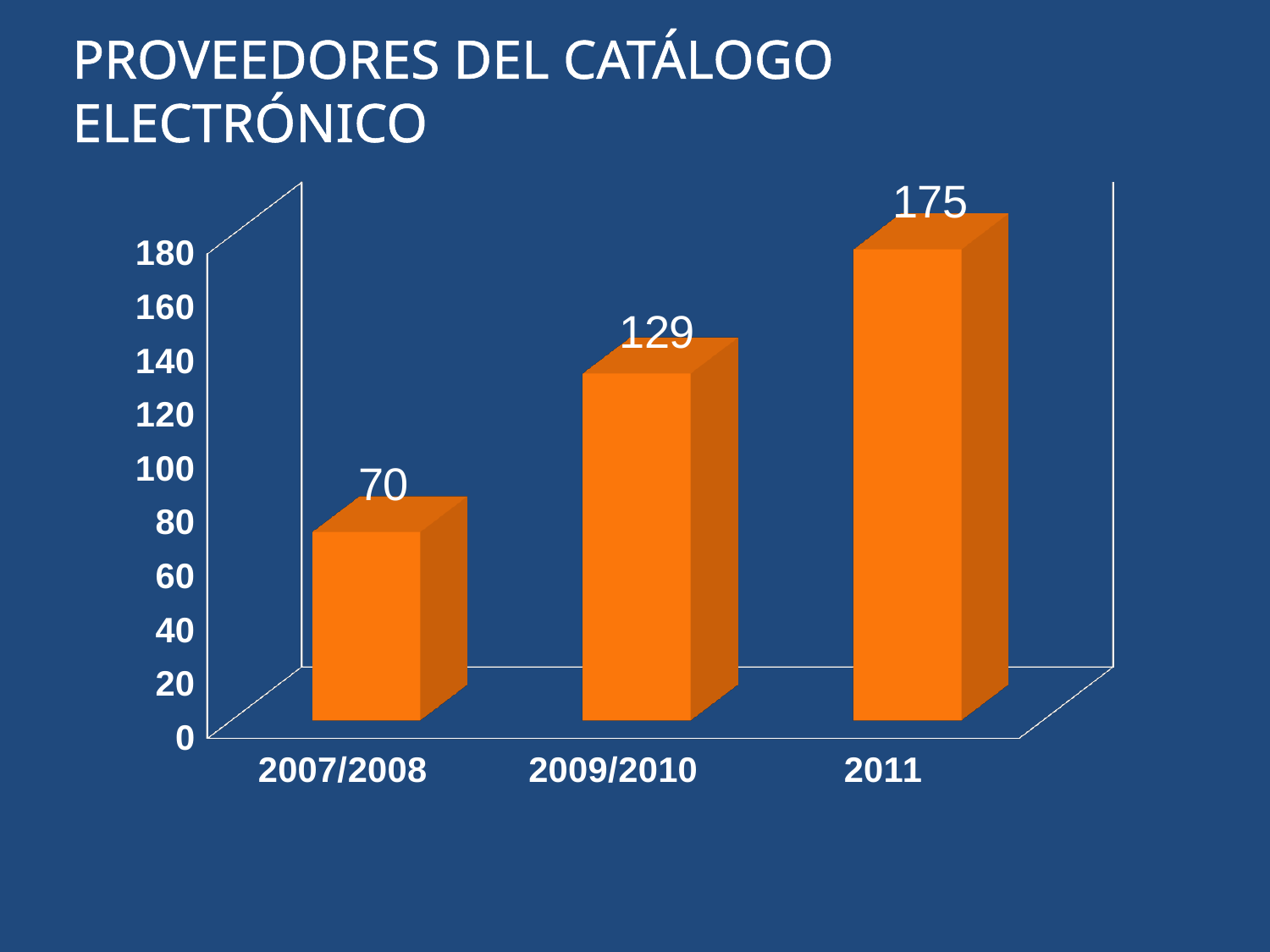
What is the value for 2009/2010? 129 What is the difference between the values for 2009/2010 and 2007/2008? 59 How many periods are shown on the x axis? 3 What is the difference between the values for 2011 and 2007/2008? 105 What is the value for 2011? 175 Which is larger, the value for 2009/2010 or the value for 2011? 2011 What kind of chart is shown on the slide? bar chart Which period has the highest value? 2011 Is the value for 2009/2010 greater or less than 120? greater What is the value for 2007/2008? 70 Do the values rise or fall from 2007/2008 to 2011? rise Which period has the lowest value? 2007/2008